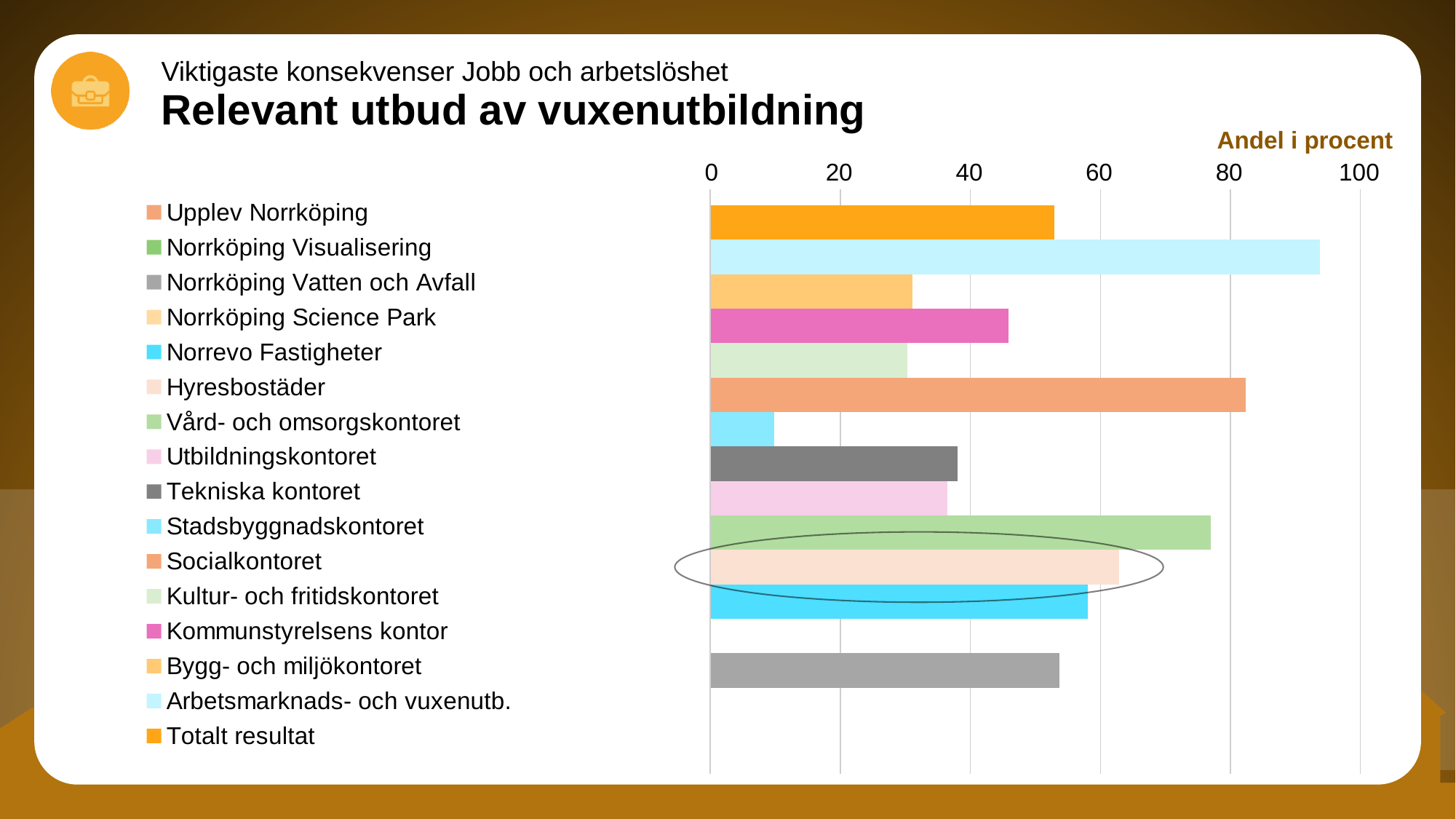
What is the label above the horizontal axis of the chart? Andel i procent Is the value for Vård- och omsorgskontoret greater or less than 80? less Is the value for Kommunstyrelsens kontor greater or less than 40? greater Which is larger, the value for Socialkontoret or the value for Kultur- och fritidskontoret? Socialkontoret Is the value for Stadsbyggnadskontoret greater or less than 20? less What kind of chart is shown on the slide? bar chart Which is larger, the value for Arbetsmarknads- och vuxenutb. or the value for Totalt resultat? Arbetsmarknads- och vuxenutb. Which legend entry has the shortest bar? Stadsbyggnadskontoret What is the highest value shown on the horizontal axis? 100 Which legend entry has the longest bar? Arbetsmarknads- och vuxenutb. How many entries does the legend list? 16